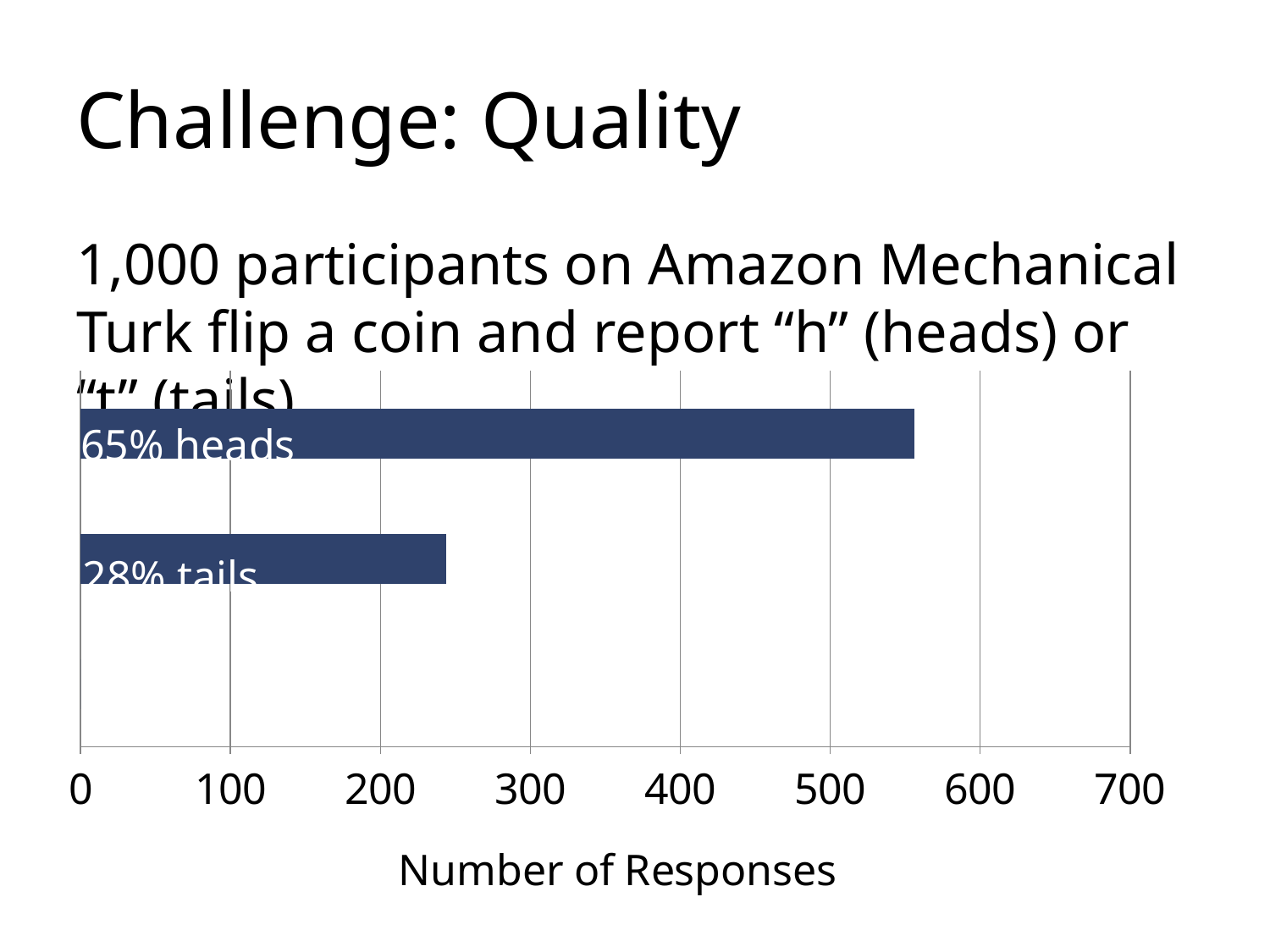
Is the number of responses for tails greater or less than 300? less What kind of chart is shown on the slide? bar chart Which has more responses, heads or tails? heads Is the number of responses for heads greater or less than 500? greater Which category has the highest number of responses? 65% heads What is the title of the horizontal axis? Number of Responses How many bars are plotted in the chart? 2 What is the maximum value shown on the horizontal axis? 700 Which category has the lowest number of responses? 28% tails Is the number of responses for tails greater or less than 200? greater